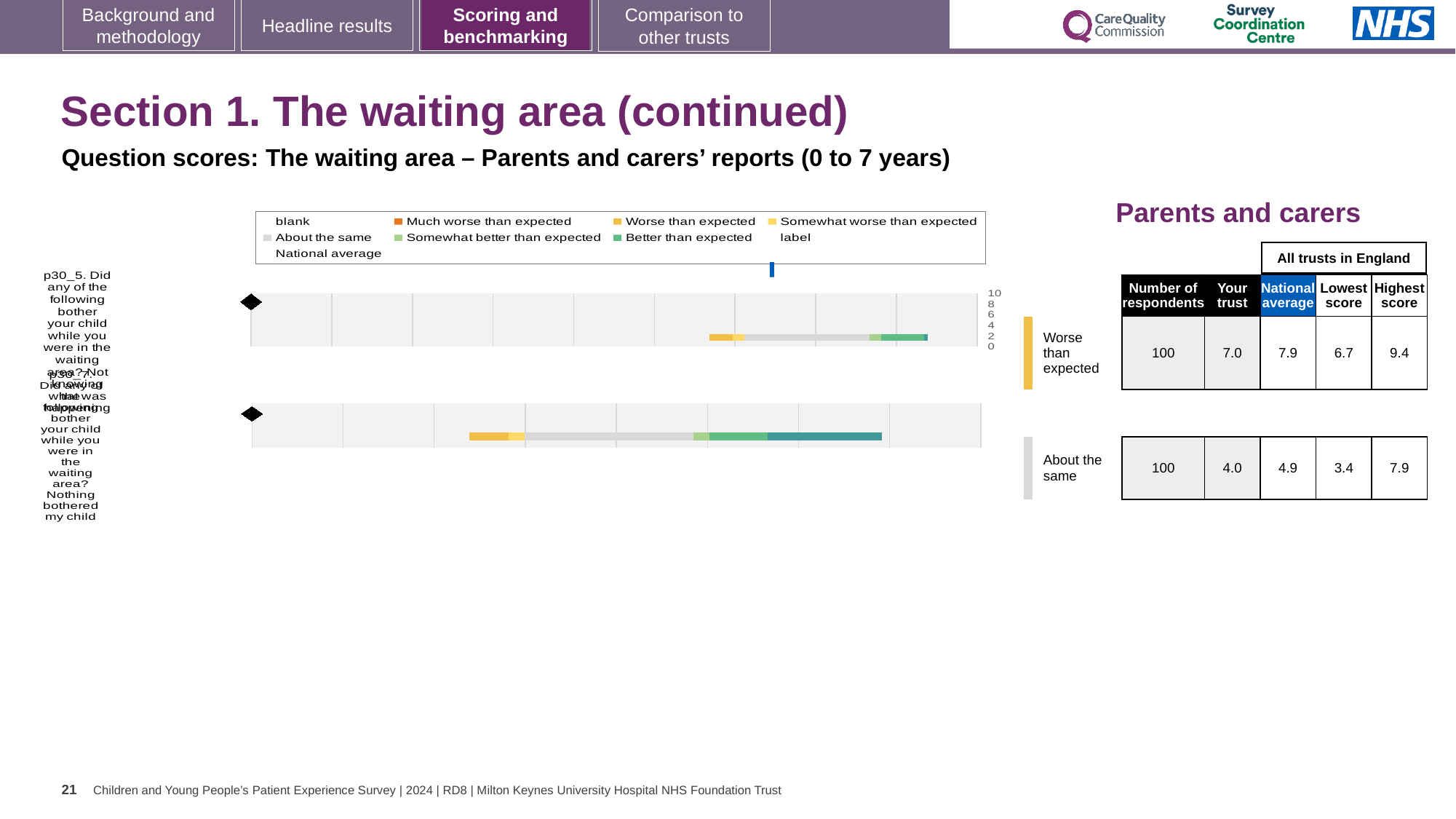
Which benchmark category is the trust's score for p30_7 (Nothing bothered my child) placed in? About the same For the bottom bar (p30_7, Nothing bothered my child), what is the national average score? 4.9 Which benchmark category is the trust's score for p30_5 (Not knowing what was happening) placed in? Worse than expected For the top bar (p30_5, Not knowing what was happening), what is the 'Your trust' score? 7.0 What is the lowest score across all trusts in England for p30_7 (Nothing bothered my child)? 3.4 How many respondents answered p30_5 (Not knowing what was happening)? 100 For p30_5 (Not knowing what was happening), how much higher is the national average than the trust's score? 0.9 What kind of chart is used to show the question scores on this slide? bar chart For p30_7 (Nothing bothered my child), what is the difference between the highest and lowest scores in England? 4.5 What is the highest score across all trusts in England for p30_5 (Not knowing what was happening)? 9.4 Which question has the higher 'Your trust' score: p30_5 (Not knowing what was happening) or p30_7 (Nothing bothered my child)? p30_5 (Not knowing what was happening) How many question bars are plotted in the chart? 2